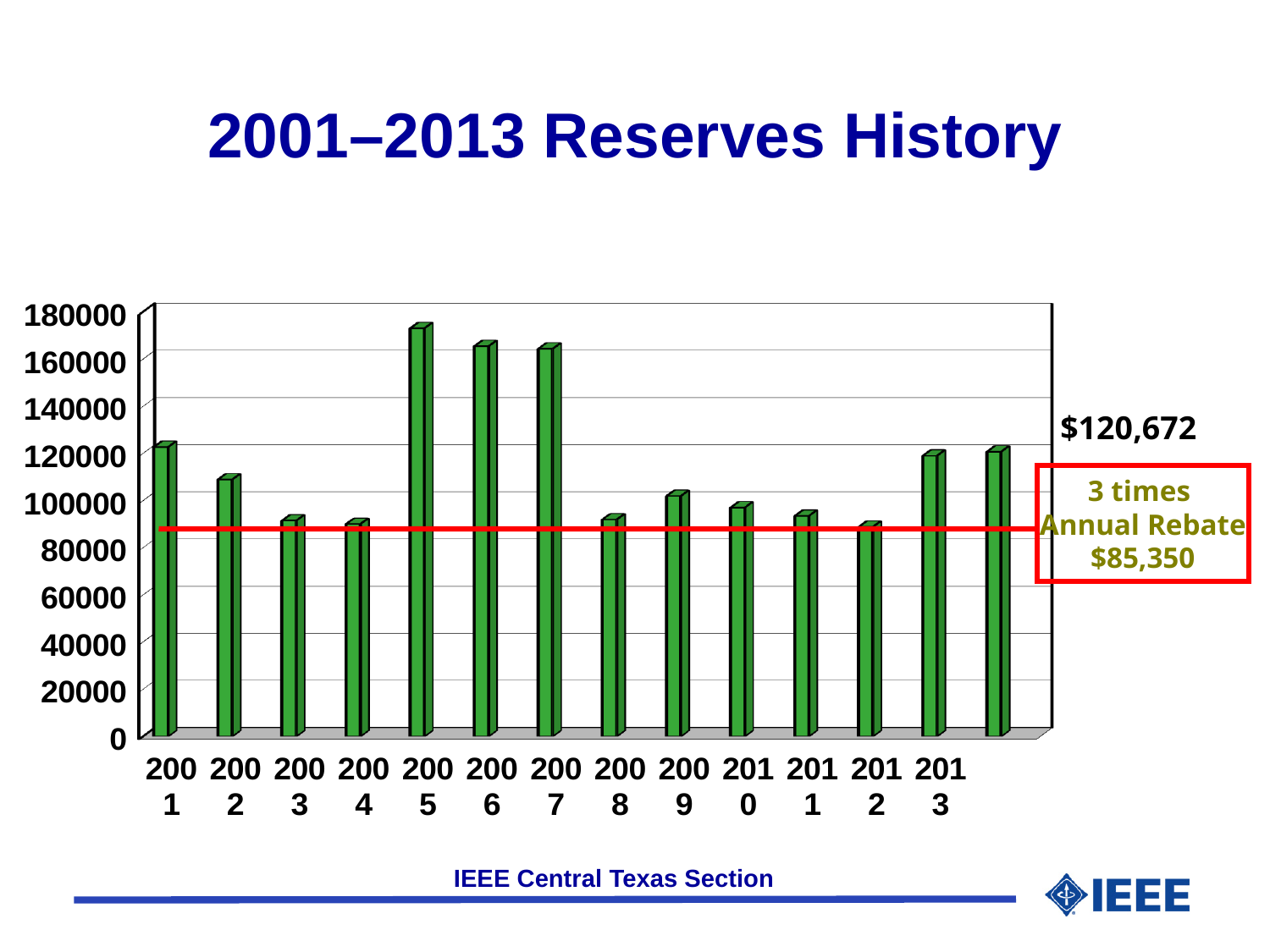
Which year has the larger reserves, 2001 or 2003? 2001 What value is annotated next to the 2013 bar? $120,672 Which year has the larger reserves, 2005 or 2002? 2005 Is the value for 2001 greater or less than 100000? greater What kind of chart is shown on the slide? bar chart Is the value for 2008 greater or less than 100000? less Is the value for 2005 greater or less than 160000? greater What value does the red horizontal line represent? $85,350 How many years are plotted on the x axis? 13 What is the title of the chart? 2001–2013 Reserves History Which year has the highest reserves? 2005